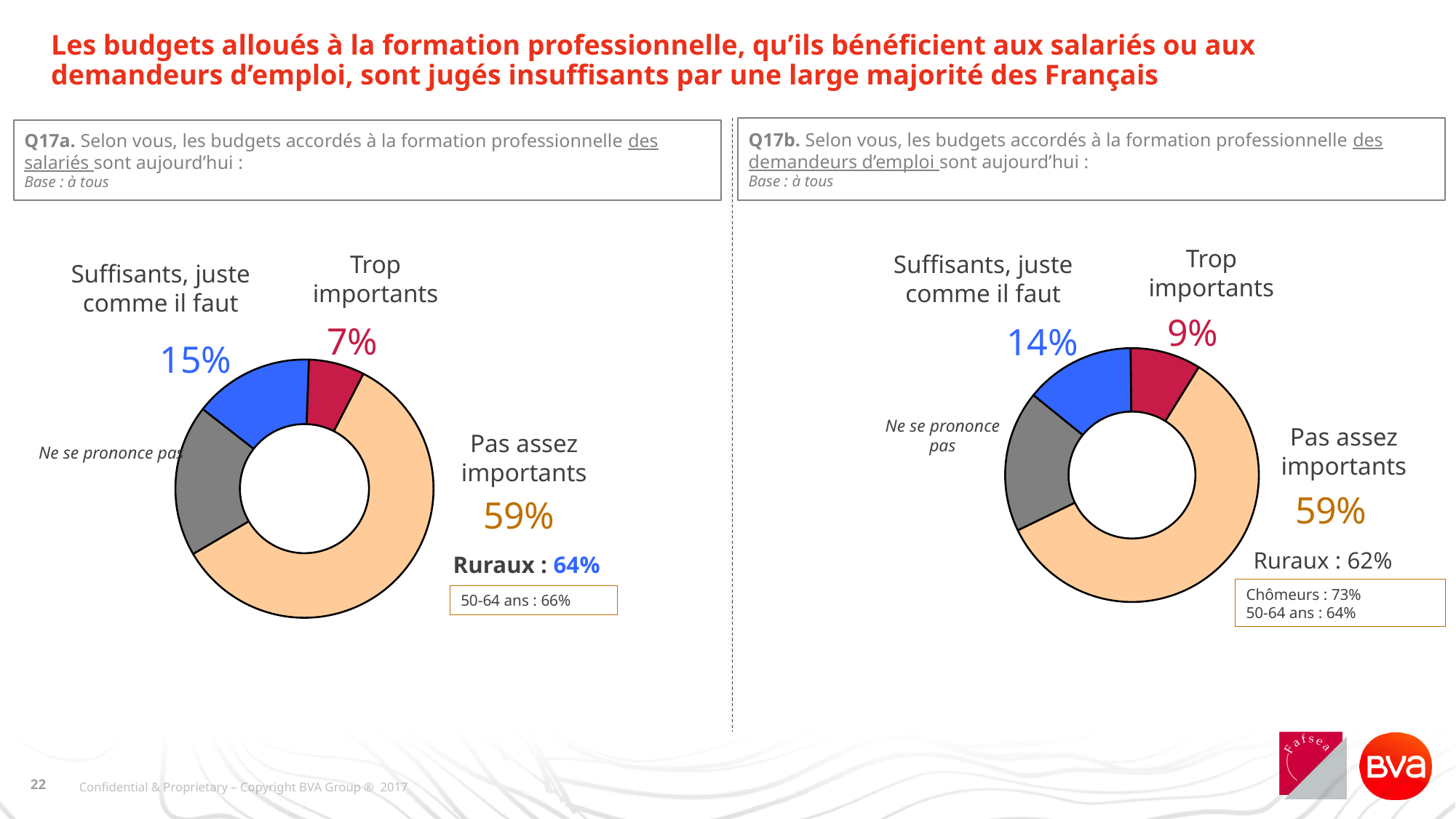
In the right chart (Q17b), what percentage answered "Suffisants, juste comme il faut"? 14% What type of chart is used on this slide? Donut (pie) chart In the left chart (Q17a), what percentage answered "Suffisants, juste comme il faut"? 15% In the right chart (Q17b, budgets for demandeurs d'emploi), what percentage answered "Trop importants"? 9% In the right chart (Q17b), which response has the largest share? Pas assez importants In the left chart (Q17a), which labelled response has the smallest share? Trop importants Which chart shows a higher share for "Trop importants", the left (Q17a) or the right (Q17b)? The right (Q17b) In the left chart (Q17a), what percentage answered "Trop importants"? 7% In the right chart (Q17b), what colour is the "Pas assez importants" segment? Light orange (peach) In the left chart (Q17a), what is the difference between "Pas assez importants" and "Suffisants, juste comme il faut"? 44 percentage points In the left chart (Q17a, budgets for salariés), what percentage answered "Pas assez importants"? 59% How many segments does the left chart (Q17a) have? 4